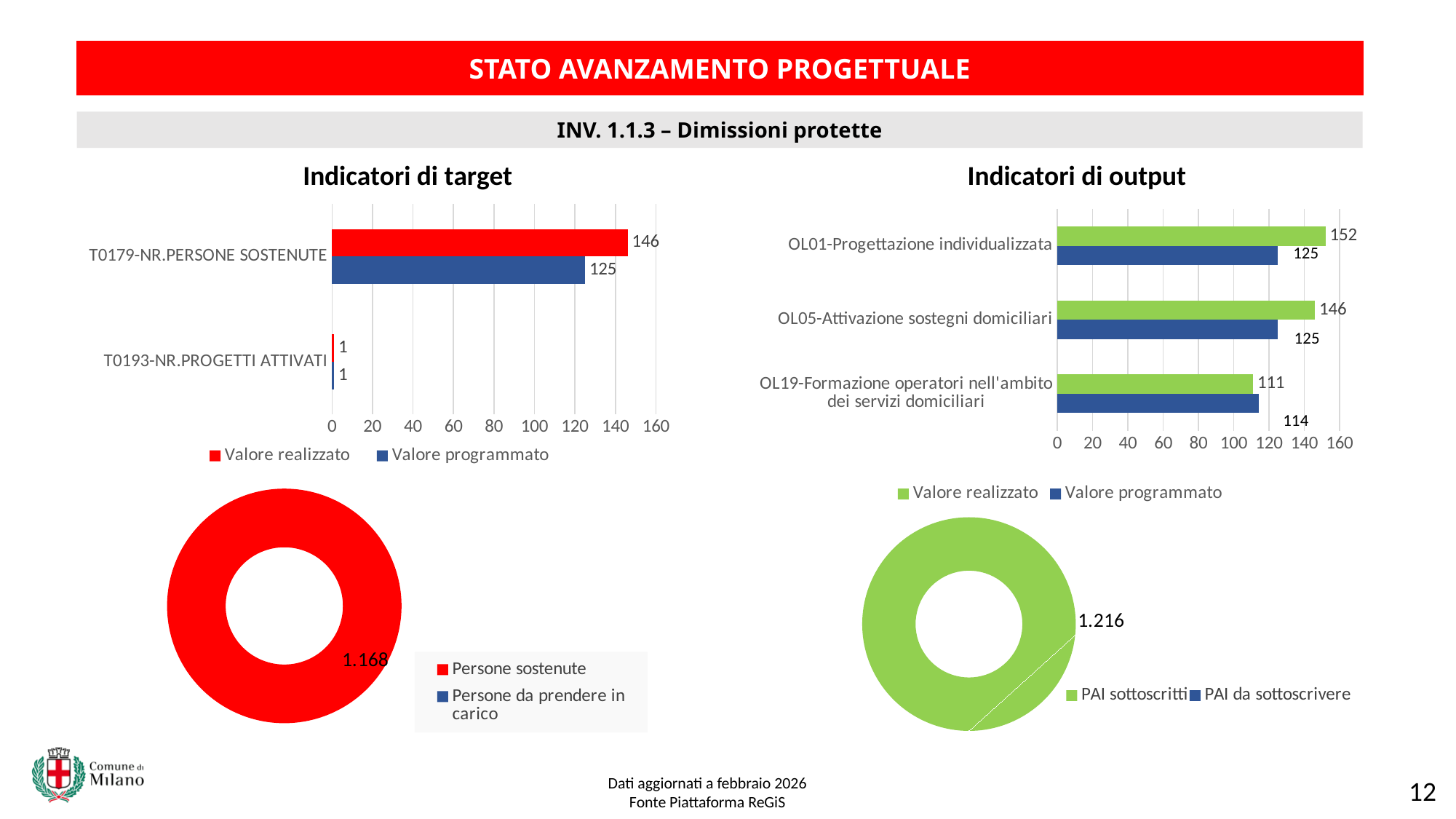
In the 'Indicatori di target' chart, what is the Valore realizzato for T0179-NR.PERSONE SOSTENUTE? 146 How many series does the legend of the 'Indicatori di target' chart list? 2 In the 'Indicatori di output' chart, what is the Valore realizzato for OL01-Progettazione individualizzata? 152 In the 'Indicatori di output' chart, which category has the highest Valore realizzato? OL01-Progettazione individualizzata What value is labelled on the doughnut chart at the bottom right of the slide (PAI sottoscritti / PAI da sottoscrivere)? 1.216 In the 'Indicatori di target' chart, what is the Valore realizzato for T0193-NR.PROGETTI ATTIVATI? 1 How many categories are shown in the 'Indicatori di output' chart? 3 In the 'Indicatori di target' chart, what is the Valore programmato for T0179-NR.PERSONE SOSTENUTE? 125 In the 'Indicatori di target' chart, what is the difference between the Valore realizzato and the Valore programmato for T0179-NR.PERSONE SOSTENUTE? 21 In the 'Indicatori di output' chart, what is the Valore programmato for OL19-Formazione operatori nell'ambito dei servizi domiciliari? 114 In the 'Indicatori di output' chart, which category has the lowest Valore realizzato? OL19-Formazione operatori nell'ambito dei servizi domiciliari In the 'Indicatori di output' chart, for OL19-Formazione operatori nell'ambito dei servizi domiciliari, which is larger: the Valore realizzato or the Valore programmato? Valore programmato